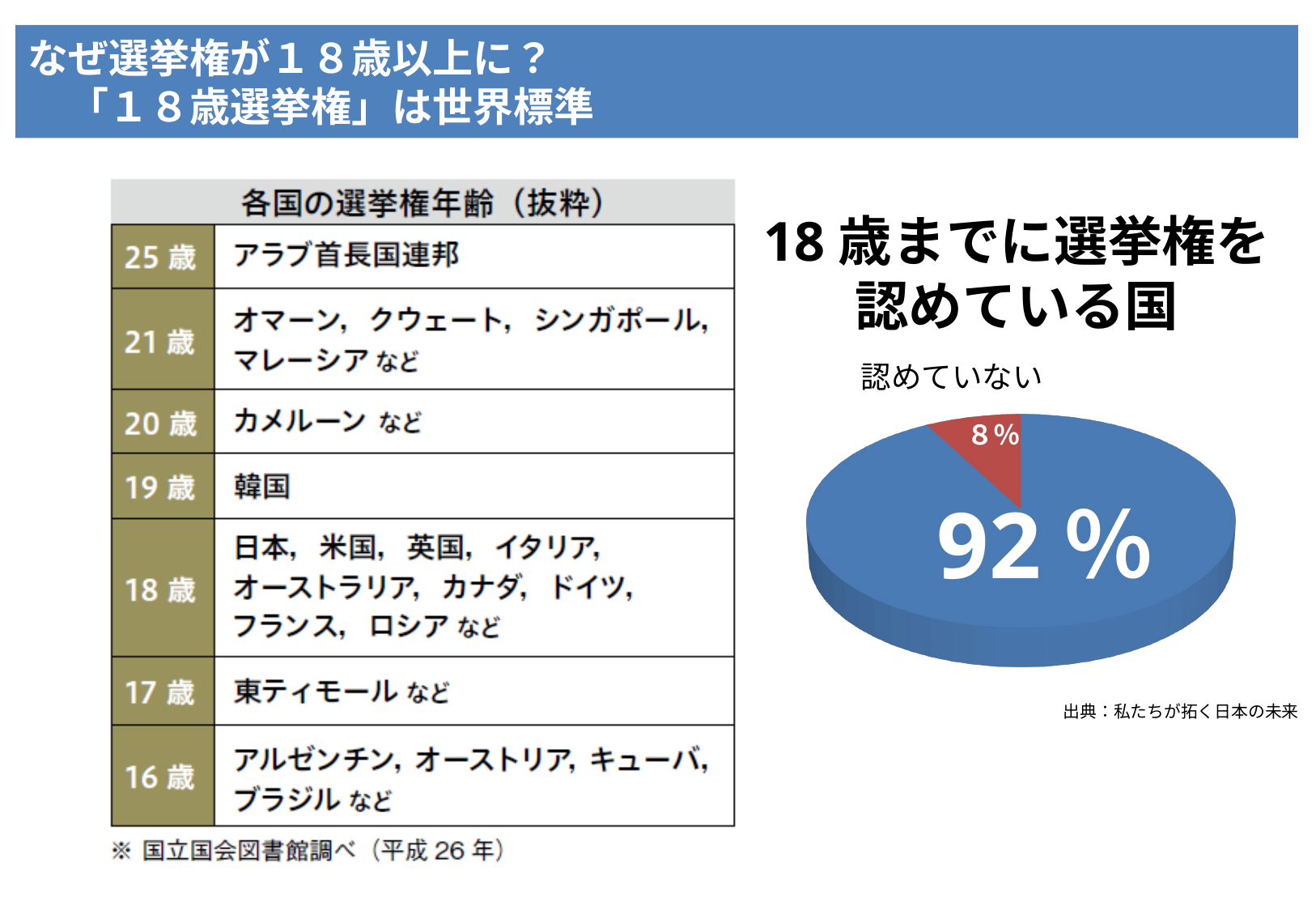
What share of the pie chart is labelled 認めていない? 8% Which slice of the pie chart is the smallest? 認めていない What is the title of the pie chart? 18歳までに選挙権を認めている国 What is the total of the two slices in the pie chart? 100% Is the value of the blue slice in the pie chart greater or less than 50%? greater Which is larger in the pie chart: the blue slice or the red slice? the blue slice What colour is the slice labelled 8% in the pie chart? red What is the value of the largest slice in the pie chart? 92% How many slices does the pie chart have? 2 What is the difference between the two slices of the pie chart? 84% What kind of chart is shown on the slide? pie chart